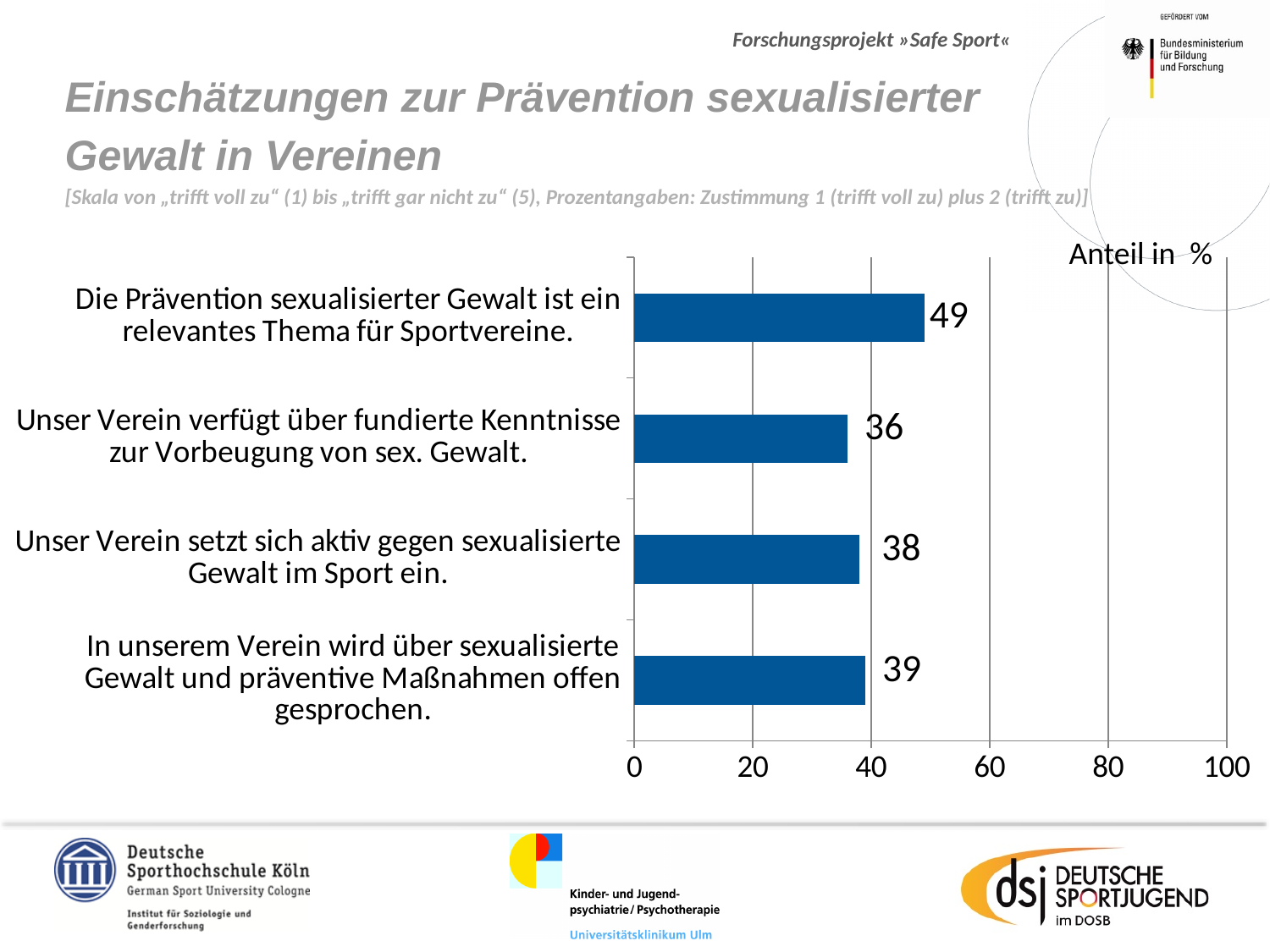
What is the difference between the value for "Die Prävention sexualisierter Gewalt ist ein relevantes Thema für Sportvereine." and the value for "Unser Verein verfügt über fundierte Kenntnisse zur Vorbeugung von sex. Gewalt."? 13 What is the value for "Die Prävention sexualisierter Gewalt ist ein relevantes Thema für Sportvereine."? 49 What is the value for "In unserem Verein wird über sexualisierte Gewalt und präventive Maßnahmen offen gesprochen."? 39 Which statement has the lowest value? Unser Verein verfügt über fundierte Kenntnisse zur Vorbeugung von sex. Gewalt. Which is larger: the value for "Unser Verein setzt sich aktiv gegen sexualisierte Gewalt im Sport ein." or the value for "Die Prävention sexualisierter Gewalt ist ein relevantes Thema für Sportvereine."? Die Prävention sexualisierter Gewalt ist ein relevantes Thema für Sportvereine. What kind of chart is shown on the slide? bar chart What is the maximum value shown on the horizontal axis? 100 What is the value for "Unser Verein setzt sich aktiv gegen sexualisierte Gewalt im Sport ein."? 38 Is the value for "Die Prävention sexualisierter Gewalt ist ein relevantes Thema für Sportvereine." greater or less than 40? greater What is the value for "Unser Verein verfügt über fundierte Kenntnisse zur Vorbeugung von sex. Gewalt."? 36 How many statements (bars) are shown in the chart? 4 Which statement has the highest value? Die Prävention sexualisierter Gewalt ist ein relevantes Thema für Sportvereine.